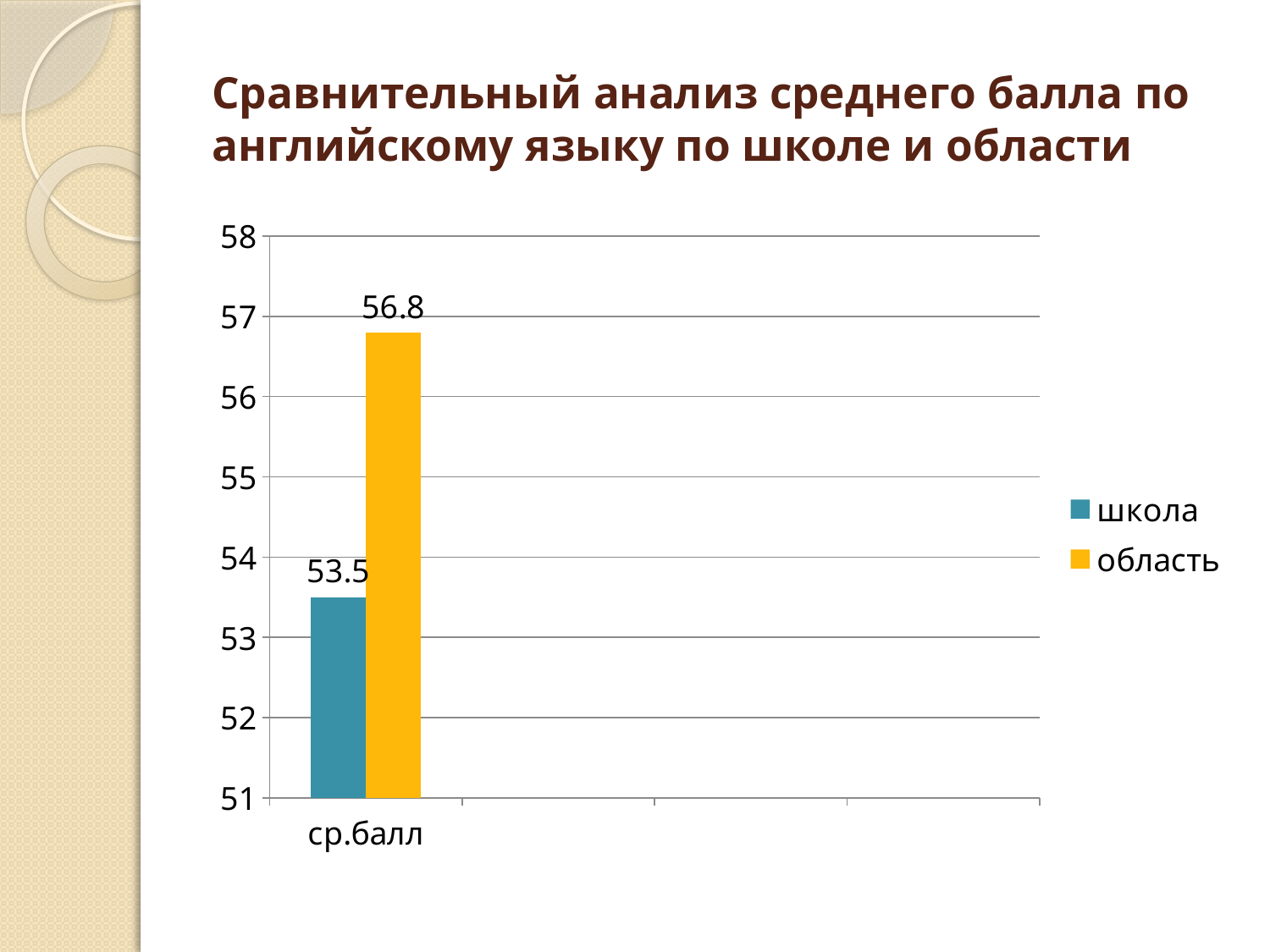
What is the label of the category on the x axis? ср.балл How many series does the legend list? 2 How many categories are shown on the x axis? 1 Which series has the higher value for ср.балл, школа or область? область What is the value for область in the ср.балл category? 56.8 Is the value for область greater or less than 56? greater What colour is the bar for область? yellow Which series has the lowest value on the chart? школа What is the value for школа in the ср.балл category? 53.5 What is the difference between the область and школа values for ср.балл? 3.3 Is the value for школа greater or less than 54? less What kind of chart is shown on the slide? bar chart